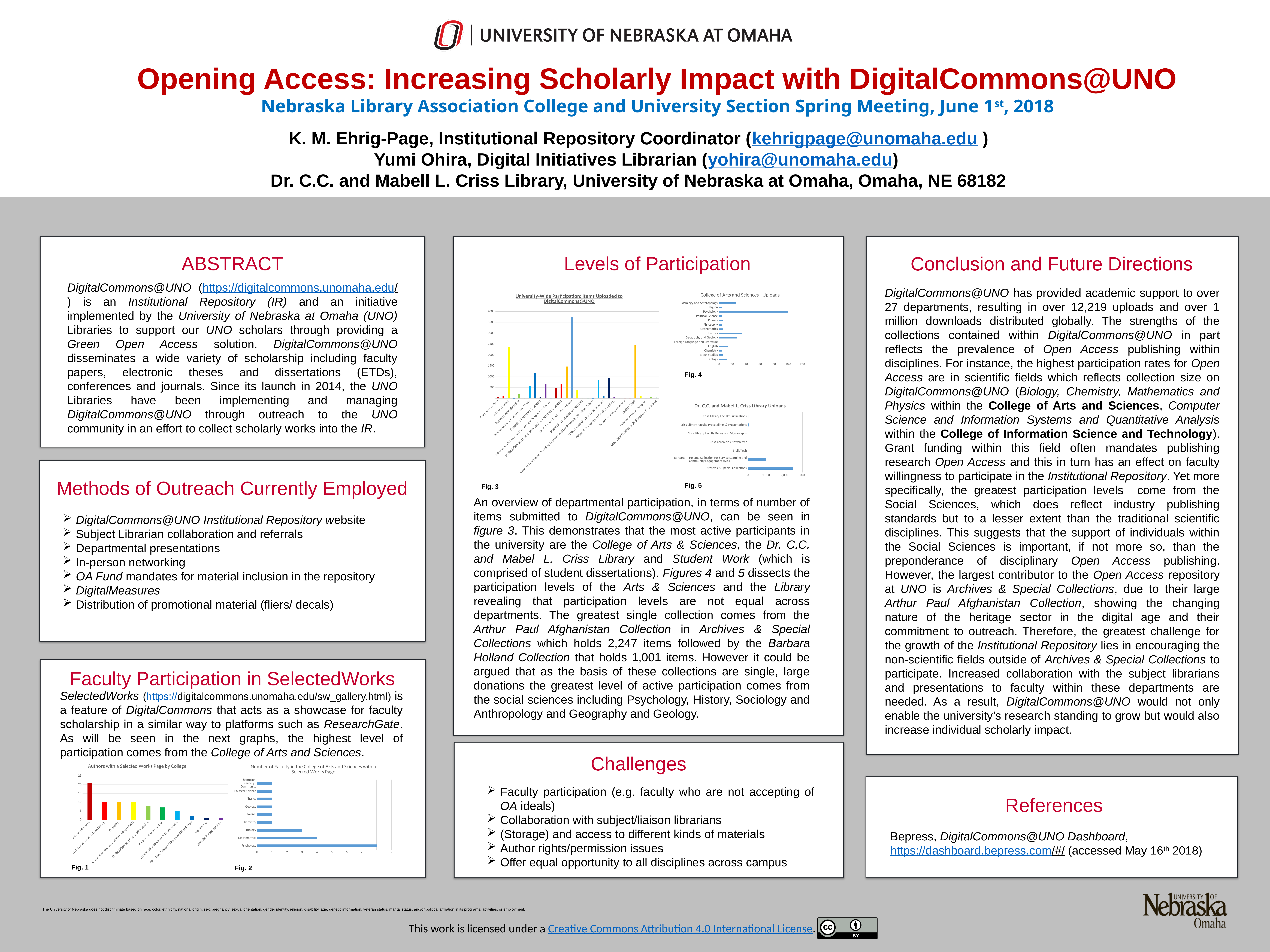
What kind of chart is Fig. 1, 'Authors with a Selected Works Page by College'? bar chart In Fig. 2, 'Number of Faculty in the College of Arts and Sciences with a Selected Works Page', is the value for Psychology greater or less than 5? greater In Fig. 3, 'University-Wide Participation: Items Uploaded to DigitalCommons@UNO', is the value for the tallest bar greater or less than 3000? greater In Fig. 5, 'Dr. C.C. and Mabel L. Criss Library Uploads', is the value for Archives & Special Collections greater or less than 2,000? greater In Fig. 4, 'College of Arts and Sciences - Uploads', which department has the highest number of uploads? Psychology In Fig. 1, 'Authors with a Selected Works Page by College', do the values rise or fall from left to right along the x axis? fall In Fig. 5, 'Dr. C.C. and Mabel L. Criss Library Uploads', which category has the highest value? Archives & Special Collections How many categories are shown in Fig. 5, 'Dr. C.C. and Mabel L. Criss Library Uploads'? 7 In Fig. 2, 'Number of Faculty in the College of Arts and Sciences with a Selected Works Page', which department has the highest value? Psychology